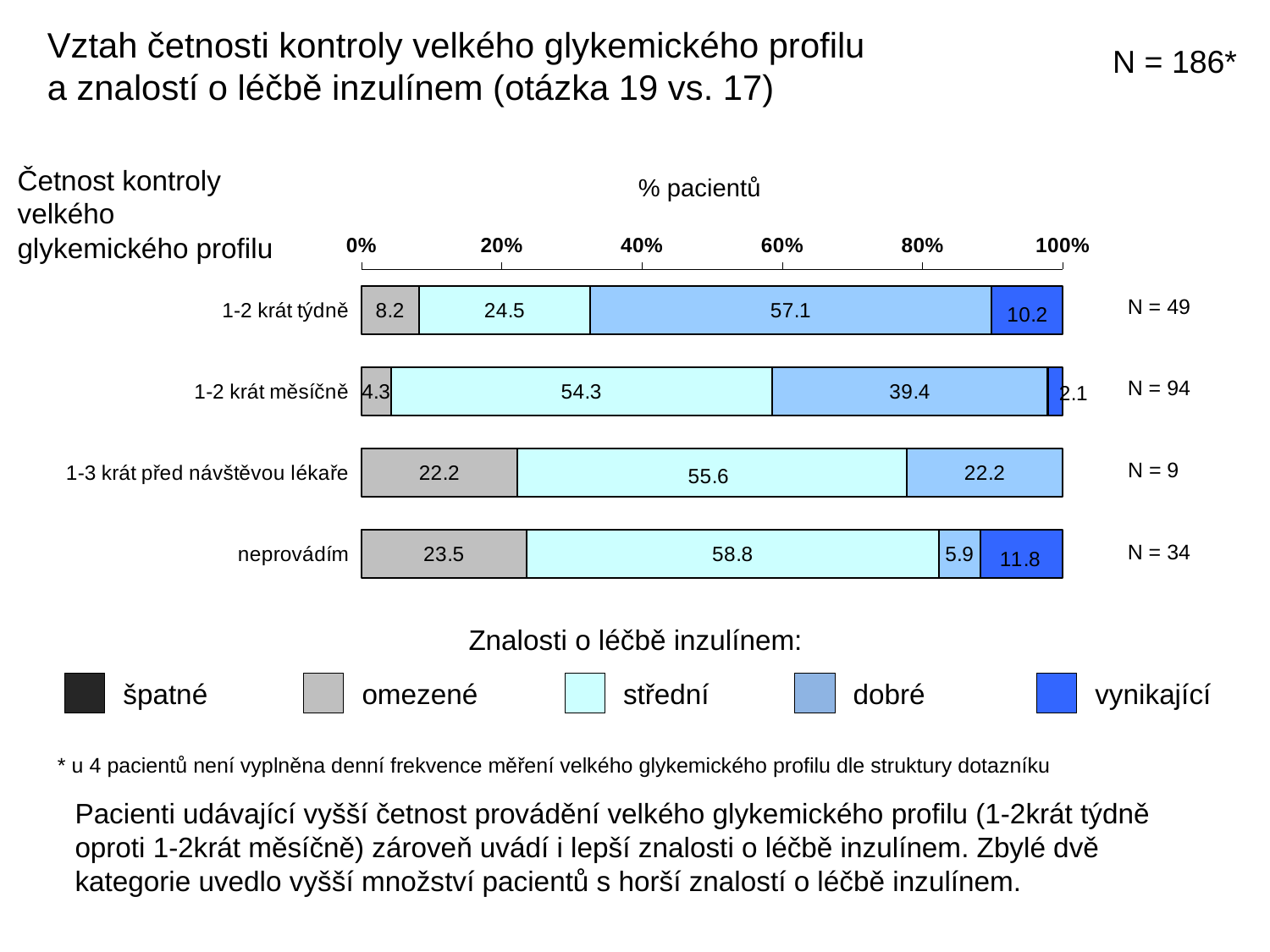
What is the N shown next to the '1-2 krát měsíčně' bar? N = 94 What is the value for 'vynikající' in the '1-2 krát měsíčně' bar? 2.1 How many series does the legend list? 5 Which category has the lowest value for 'omezené'? 1-2 krát měsíčně What is the value for 'střední' in the 'neprovádím' bar? 58.8 What is the difference between the 'dobré' values for '1-2 krát týdně' and '1-2 krát měsíčně'? 17.7 Which category has the highest value for 'střední'? neprovádím Which category has the larger 'vynikající' value: '1-2 krát týdně' or 'neprovádím'? neprovádím How many categories (bars) are shown in the chart? 4 What is the value for 'omezené' in the '1-3 krát před návštěvou lékaře' bar? 22.2 What kind of chart is shown on the slide? Stacked bar chart What is the value for 'dobré' in the '1-2 krát týdně' bar? 57.1